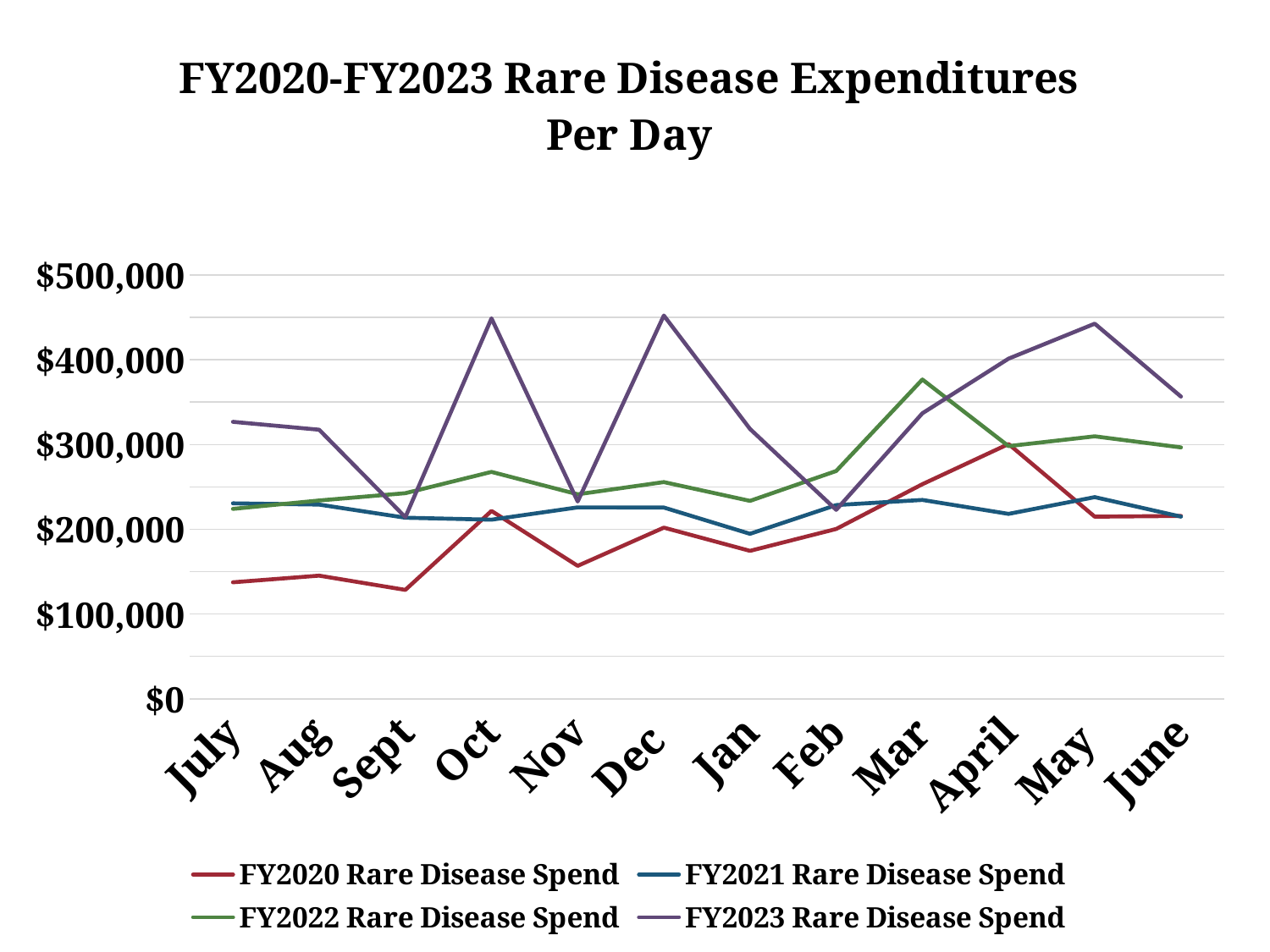
In which month is the FY2022 Rare Disease Spend highest? Mar Is the FY2020 Rare Disease Spend value for Sept greater or less than $200,000? less Does the FY2023 Rare Disease Spend rise or fall from Sept to Oct? rise In Oct, which is larger: FY2023 Rare Disease Spend or FY2021 Rare Disease Spend? FY2023 Rare Disease Spend How many series does the legend list? 4 How many months are shown along the x axis? 12 Is the FY2021 Rare Disease Spend value for July greater or less than $300,000? less What type of chart is shown on the slide? line chart What is the title of the chart? FY2020-FY2023 Rare Disease Expenditures Per Day Is the FY2023 Rare Disease Spend value for Oct greater or less than $400,000? greater In which month is the FY2020 Rare Disease Spend highest? April